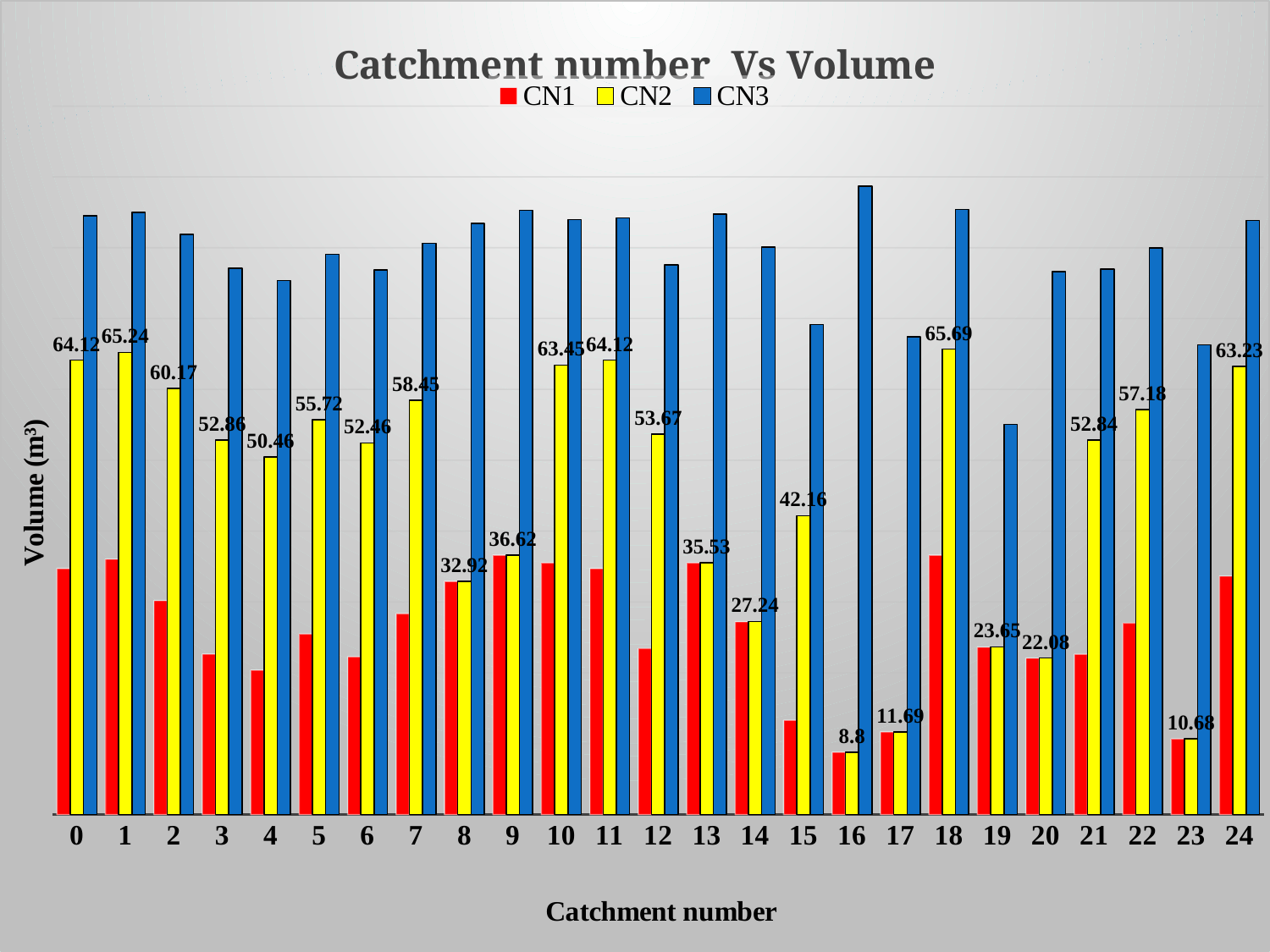
Which catchment number has the highest CN2 value? 18 What type of chart is shown on the slide? bar chart How many catchment numbers are shown on the x axis? 25 What is the difference between the CN2 values for catchment 1 and catchment 0? 1.12 Which is larger, the CN2 value for catchment 0 or the CN2 value for catchment 8? catchment 0 What is the difference between the CN2 values for catchment 18 and catchment 16? 56.89 What is the CN2 value for catchment number 15? 42.16 What is the CN2 value for catchment number 7? 58.45 Which catchment number has the tallest CN3 bar? 16 How many series does the legend list? 3 What is the CN2 value for catchment number 23? 10.68 Which catchment number has the lowest CN2 value? 16